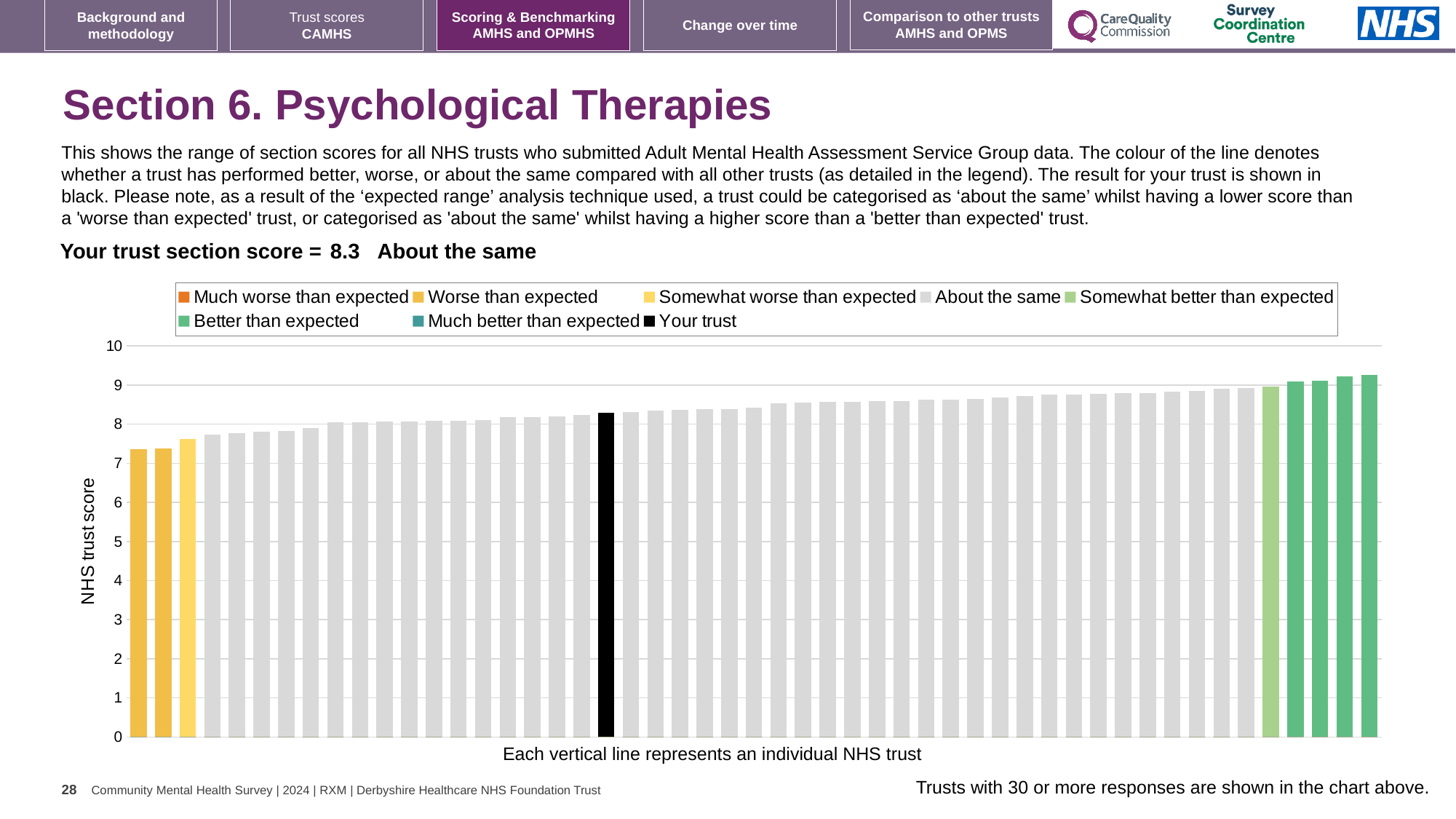
Is the value for the leftmost bar greater or less than 8? less How many entries does the chart legend list? 8 Which is larger: the rightmost bar or the black 'Your trust' bar? the rightmost bar What is the section score for your trust shown on the slide? 8.3 Which performance category is your trust placed in for this section? About the same What kind of chart is shown on the slide? bar chart What colour is the bar representing your trust? black Is the value for the rightmost bar greater or less than 9? greater What is the label on the vertical axis of the chart? NHS trust score Is the value for the black 'Your trust' bar greater or less than 8? greater Which is larger: the black 'Your trust' bar or the leftmost bar? Your trust Do the bar values rise or fall from left to right along the x axis? rise